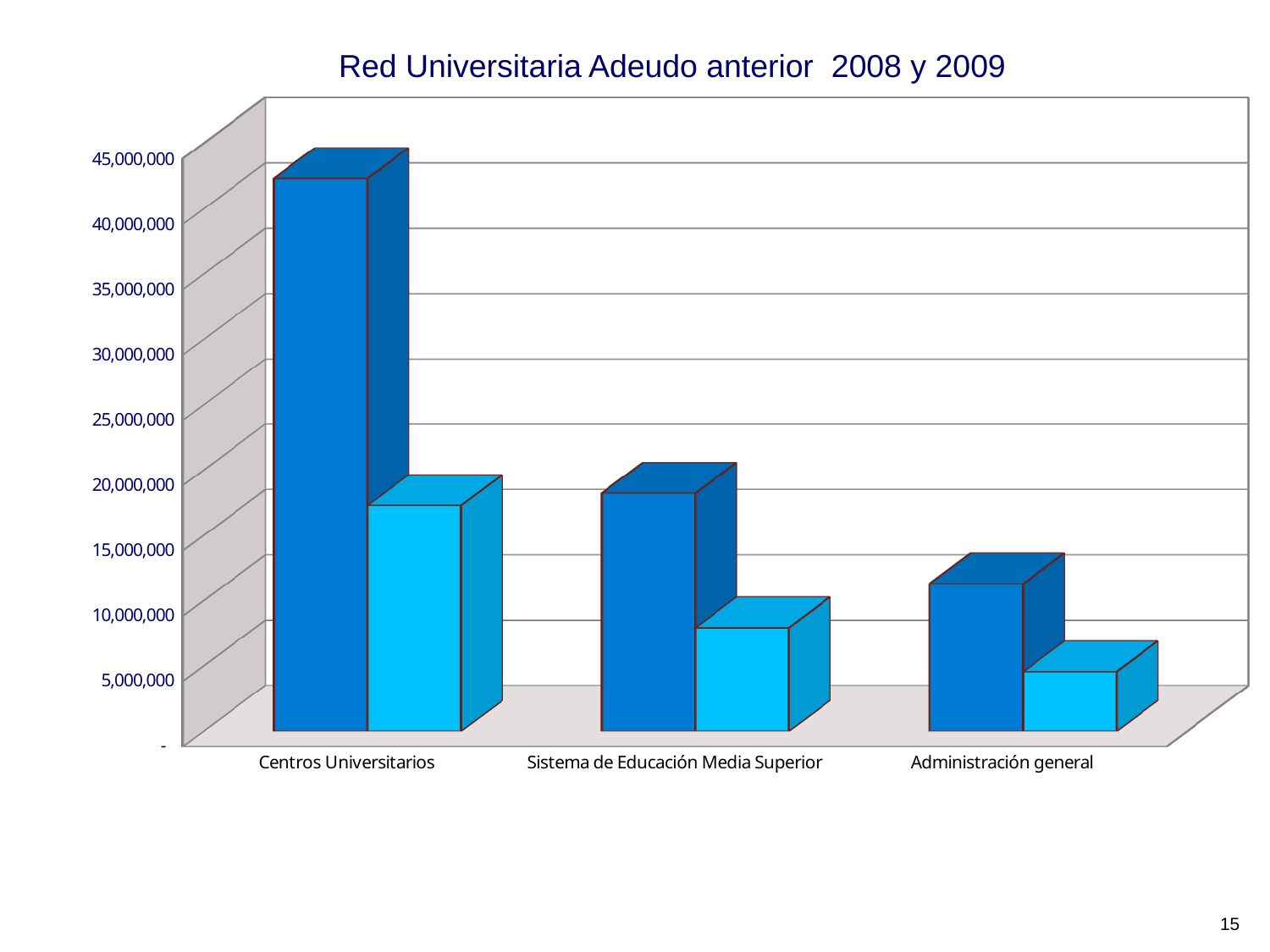
Is the light blue bar for Centros Universitarios greater or less than 25,000,000? less Which category has the shortest light blue bar? Administración general Is the dark blue bar for Sistema de Educación Media Superior greater or less than 15,000,000? greater Which category has the tallest dark blue bar? Centros Universitarios How many categories are shown on the x axis? 3 What kind of chart is shown on the slide? bar chart For Centros Universitarios, which bar is larger, the dark blue or the light blue? dark blue Is the light blue bar for Administración general greater or less than 10,000,000? less What is the title of the chart? Red Universitaria Adeudo anterior 2008 y 2009 How many bars are plotted for each category? 2